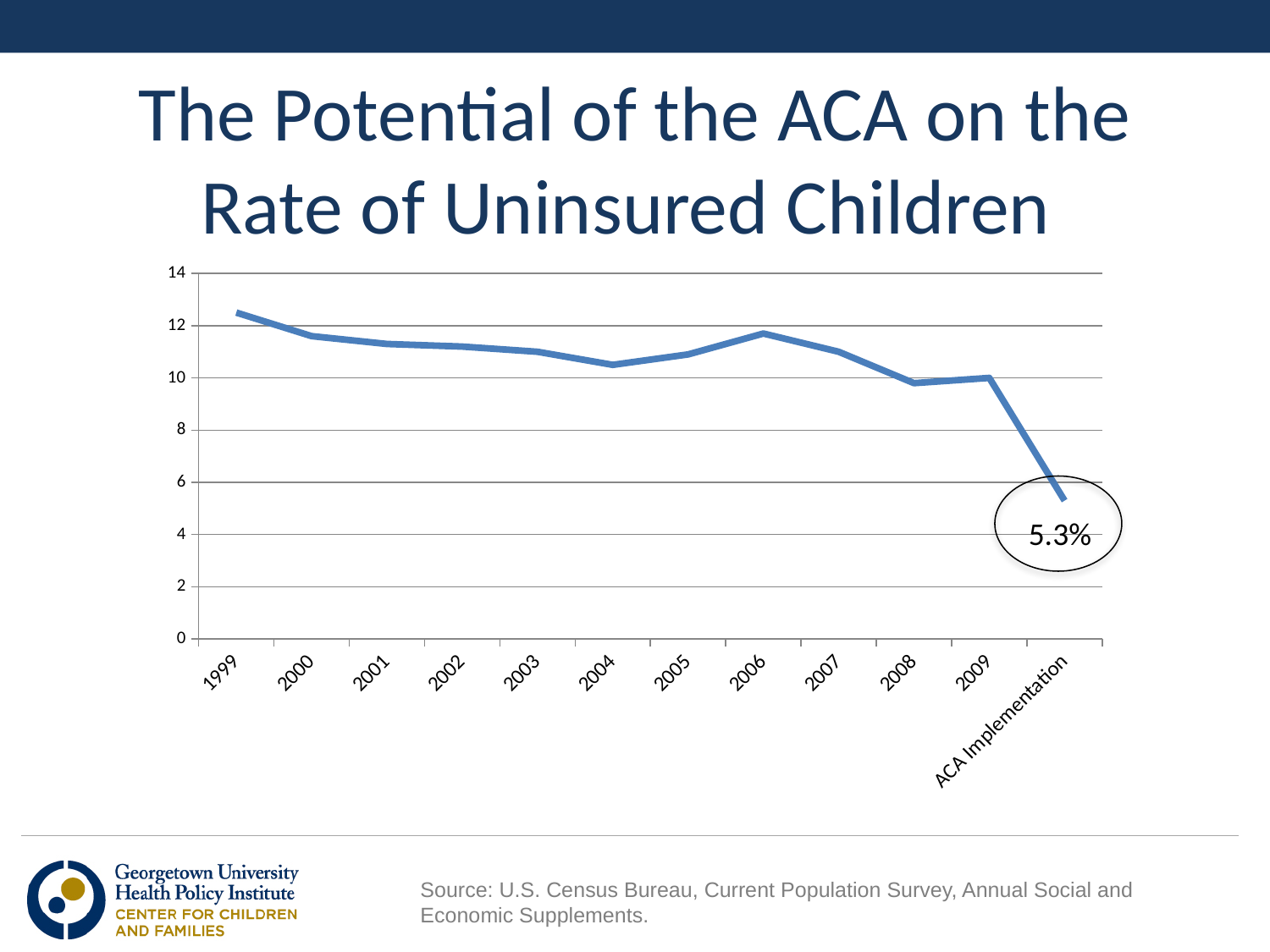
What kind of chart is shown on the slide? line chart Is the value for 2006 greater or less than 12? less Which point on the x axis has the lowest value? ACA Implementation Is the value for ACA Implementation greater or less than 6? less Which year has the highest value on the line? 1999 Does the line generally rise or fall from 1999 to ACA Implementation? fall Is the value for 2004 greater or less than 10? greater Which is larger, the value for 1999 or the value for 2008? 1999 How many points are plotted along the x axis? 12 What is the title of the slide? The Potential of the ACA on the Rate of Uninsured Children What is the value shown for ACA Implementation? 5.3%